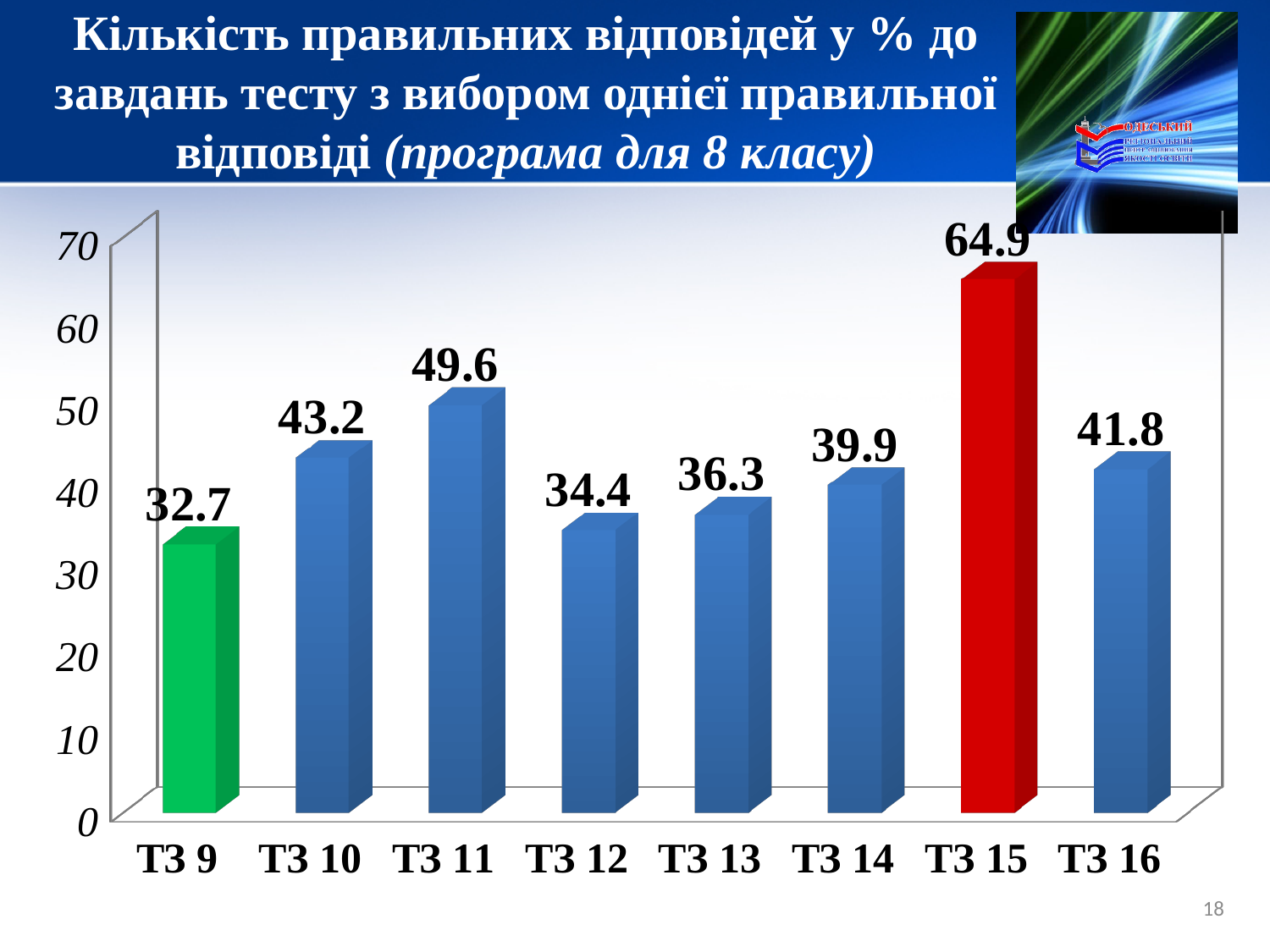
Which category has the lowest value? ТЗ 9 What is the difference between the values for ТЗ 15 and ТЗ 9? 32.2 Which is larger, the value for ТЗ 14 or the value for ТЗ 16? ТЗ 16 Which category has the highest value? ТЗ 15 What kind of chart is shown on the slide? bar chart Is the value for ТЗ 15 greater or less than 60? greater What colour is the bar for ТЗ 15? red How many categories are shown on the x axis? 8 What is the value for ТЗ 16? 41.8 What is the difference between the values for ТЗ 10 and ТЗ 12? 8.8 What is the value for ТЗ 13? 36.3 What is the value for ТЗ 11? 49.6